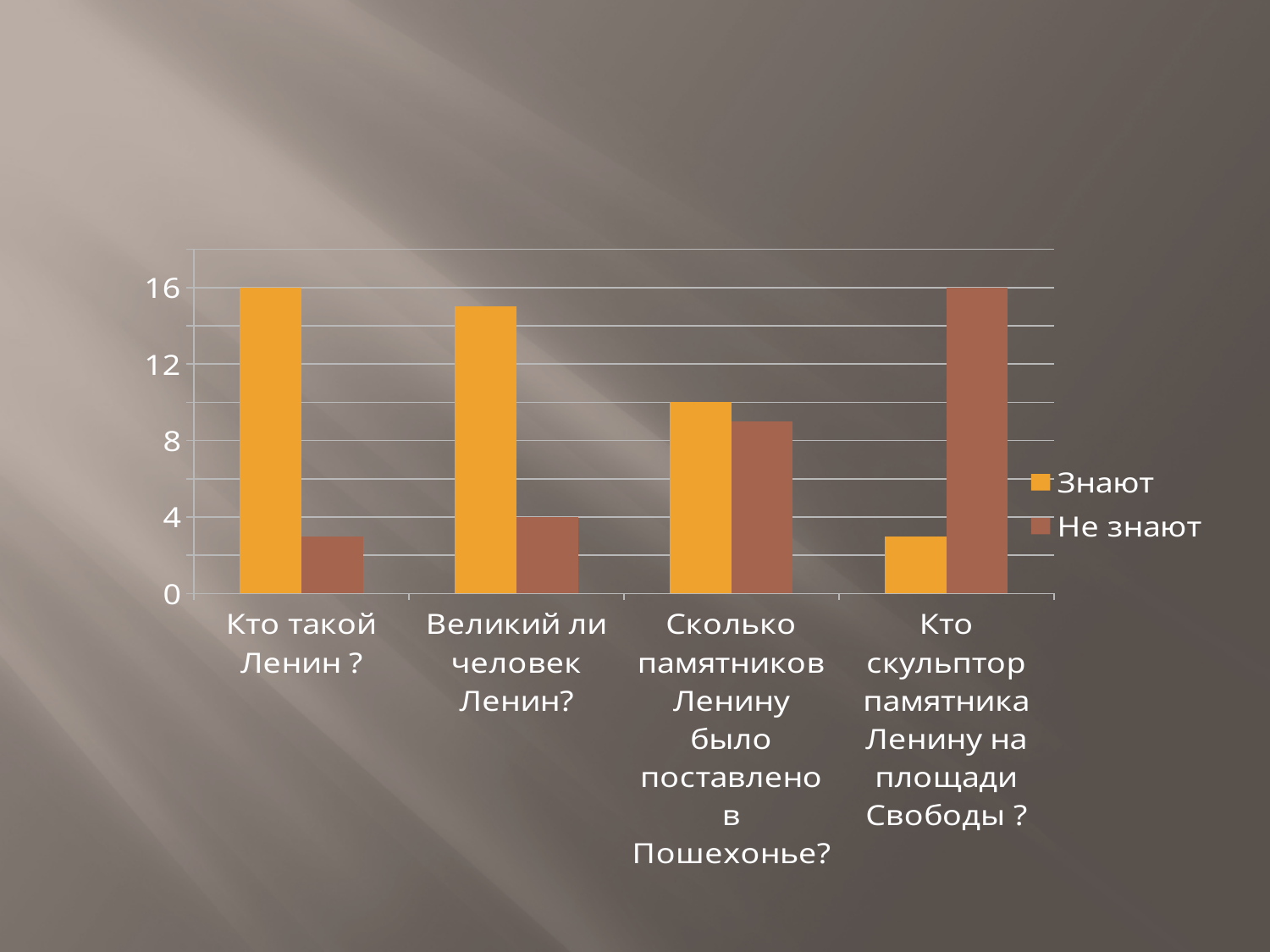
Is the value of "Знают" for "Кто скульптор памятника Ленину на площади Свободы ?" greater or less than 4? less Is the value of "Не знают" for "Кто такой Ленин ?" greater or less than 4? less How many categories (questions) are shown on the x axis of the chart? 4 For which category is the "Знают" value lowest? Кто скульптор памятника Ленину на площади Свободы ? For "Великий ли человек Ленин?", which is larger: "Знают" or "Не знают"? Знают What is the value of "Знают" for "Кто такой Ленин ?"? 16 For which category is the "Не знают" value highest? Кто скульптор памятника Ленину на площади Свободы ? What kind of chart is shown on the slide? bar chart What are the two series named in the legend? Знают, Не знают What is the value of "Не знают" for "Кто скульптор памятника Ленину на площади Свободы ?"? 16 Is the value of "Знают" for "Сколько памятников Ленину было поставлено в Пошехонье?" greater or less than 8? greater How many series does the legend list? 2